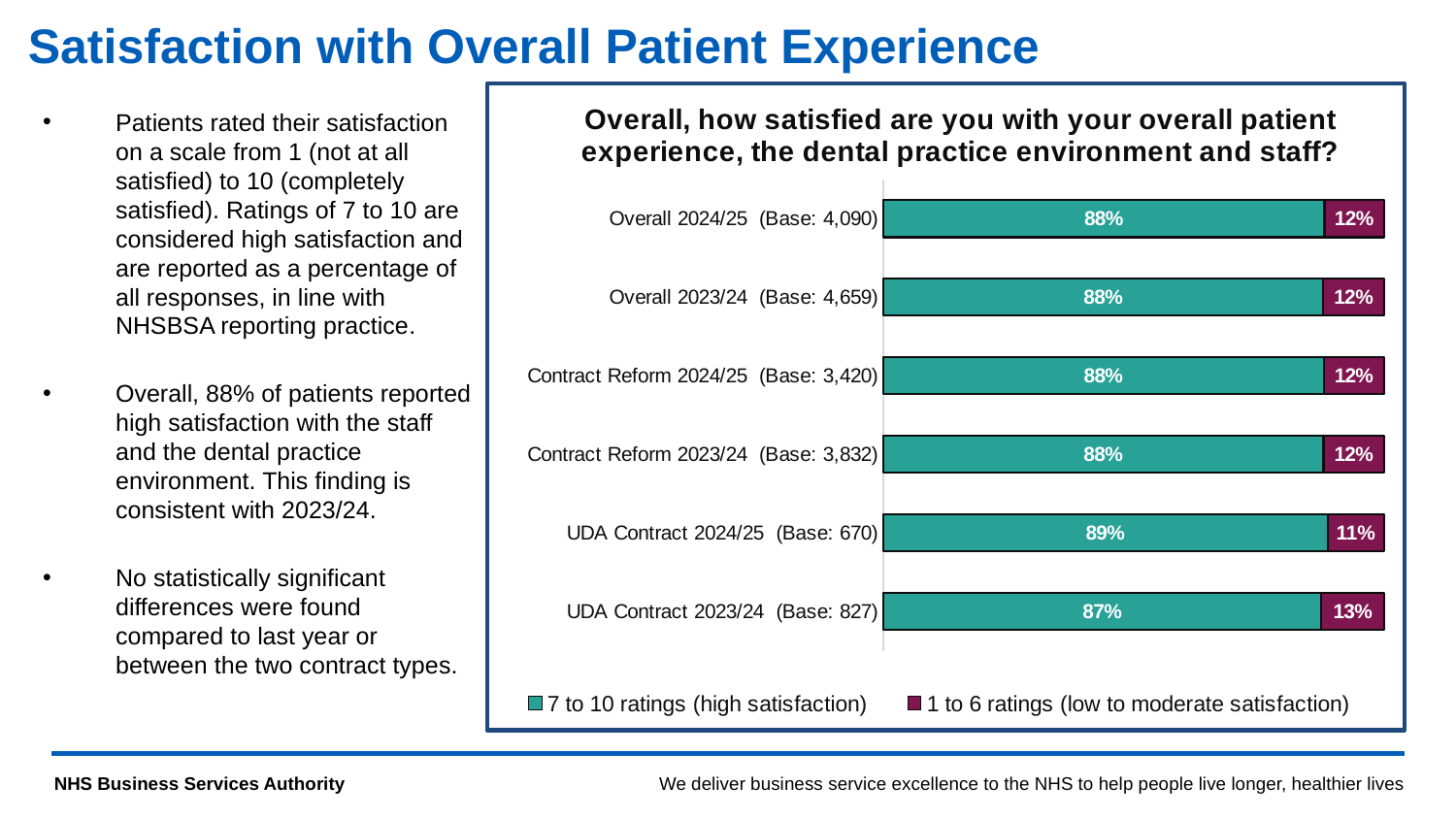
Which category has the highest percentage of 7 to 10 ratings (high satisfaction)? UDA Contract 2024/25 How many categories are shown on the chart? 6 Which category has the lowest percentage of 7 to 10 ratings (high satisfaction)? UDA Contract 2023/24 What is the value for 7 to 10 ratings (high satisfaction) for Overall 2024/25? 88% What percentage of UDA Contract 2024/25 respondents gave 7 to 10 ratings (high satisfaction)? 89% How many series does the legend list? 2 What kind of chart is shown on the slide? Stacked bar chart What is the total of the stacked bar for Contract Reform 2024/25? 100% What is the difference in 7 to 10 ratings (high satisfaction) between UDA Contract 2024/25 and UDA Contract 2023/24? 2% What is the value for 1 to 6 ratings (low to moderate satisfaction) for Contract Reform 2023/24? 12% What percentage of UDA Contract 2023/24 respondents gave 1 to 6 ratings (low to moderate satisfaction)? 13% Which has a larger share of 1 to 6 ratings (low to moderate satisfaction): UDA Contract 2023/24 or Overall 2023/24? UDA Contract 2023/24